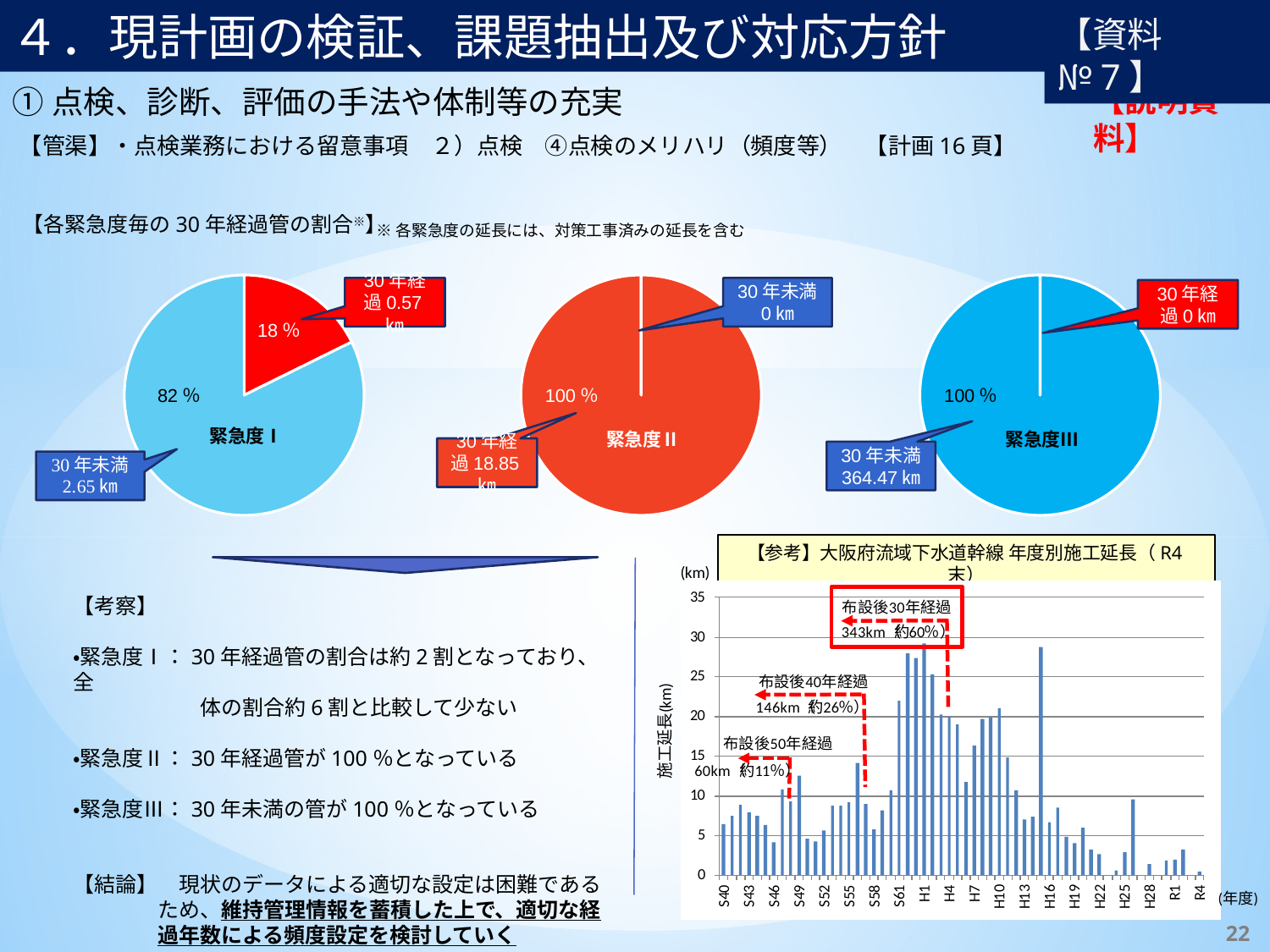
In the 緊急度Ⅲ pie chart, what share of the pie is labelled 30年未満? 100% In the 大阪府流域下水道幹線 年度別施工延長 bar chart, is the value for H16 greater or less than 25? greater In the 緊急度Ⅱ pie chart, what length is given for 30年未満? 0 km In the 緊急度Ⅰ pie chart, what length is given for 30年未満? 2.65 km In the 緊急度Ⅱ pie chart, what length is given for 30年経過? 18.85 km In the 緊急度Ⅰ pie chart, what length is given for 30年経過? 0.57 km In the 大阪府流域下水道幹線 年度別施工延長 bar chart, is the value for S40 greater or less than 10? less In the 緊急度Ⅰ pie chart, which is larger, the 30年未満 slice or the 30年経過 slice? 30年未満 In the 緊急度Ⅰ pie chart, what share of the pie is labelled 30年経過? 18% What kind of chart is the 大阪府流域下水道幹線 年度別施工延長 chart at the bottom right? bar chart In the 緊急度Ⅲ pie chart, what length is given for 30年未満? 364.47 km In the 緊急度Ⅰ pie chart, what share of the pie is labelled 30年未満? 82%